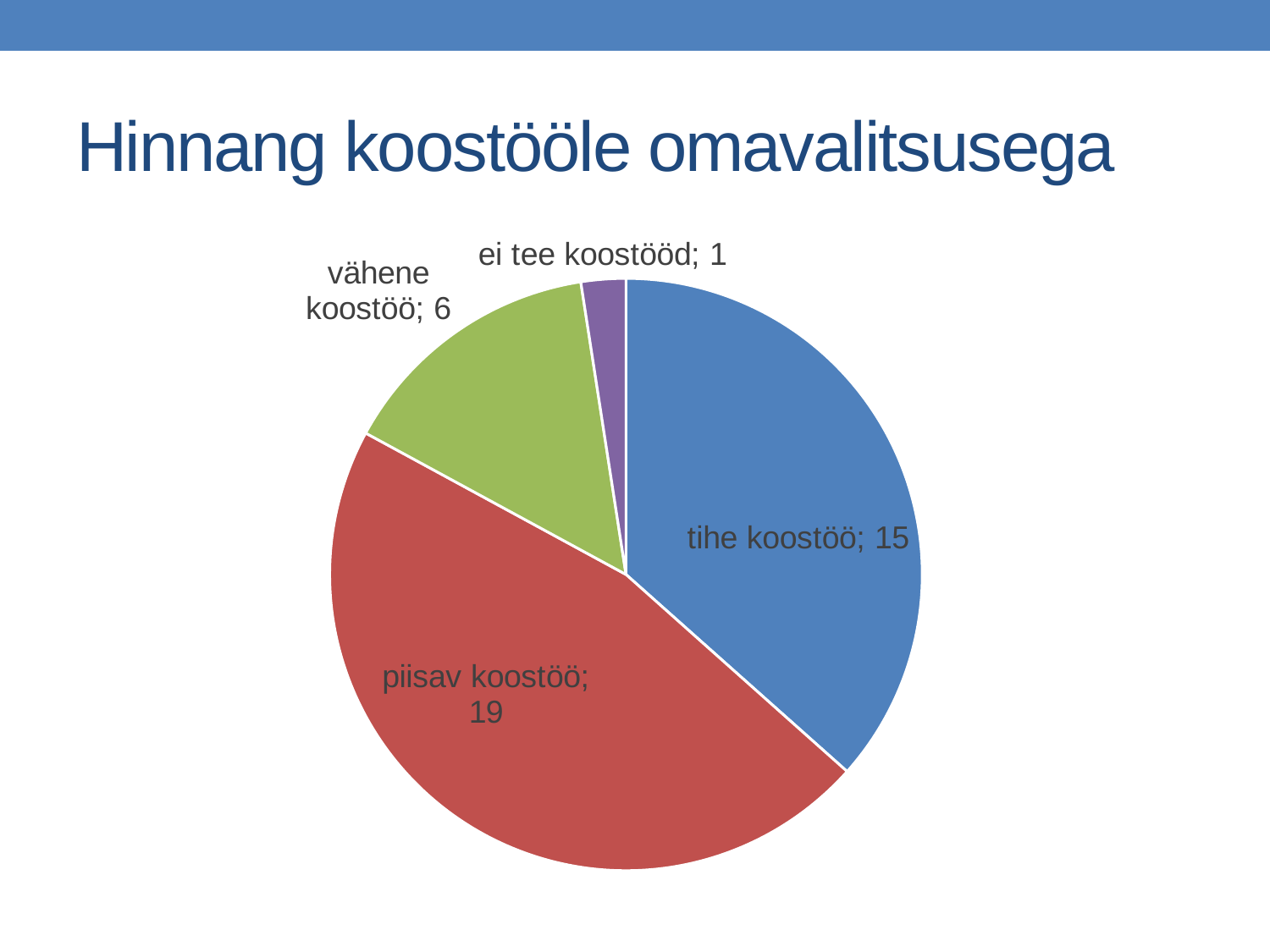
How many categories are shown in the pie chart? 4 What is the value for "piisav koostöö"? 19 Which category has the largest slice of the pie? piisav koostöö What is the value for "ei tee koostööd"? 1 What type of chart is shown on the slide? pie chart What is the value for "tihe koostöö"? 15 Which is larger, the value for "vähene koostöö" or the value for "tihe koostöö"? tihe koostöö What is the total of all the slice values in the pie chart? 41 What is the difference between the values for "piisav koostöö" and "tihe koostöö"? 4 Which category has the smallest slice of the pie? ei tee koostööd What is the title of the chart on the slide? Hinnang koostööle omavalitsusega What is the value for "vähene koostöö"? 6